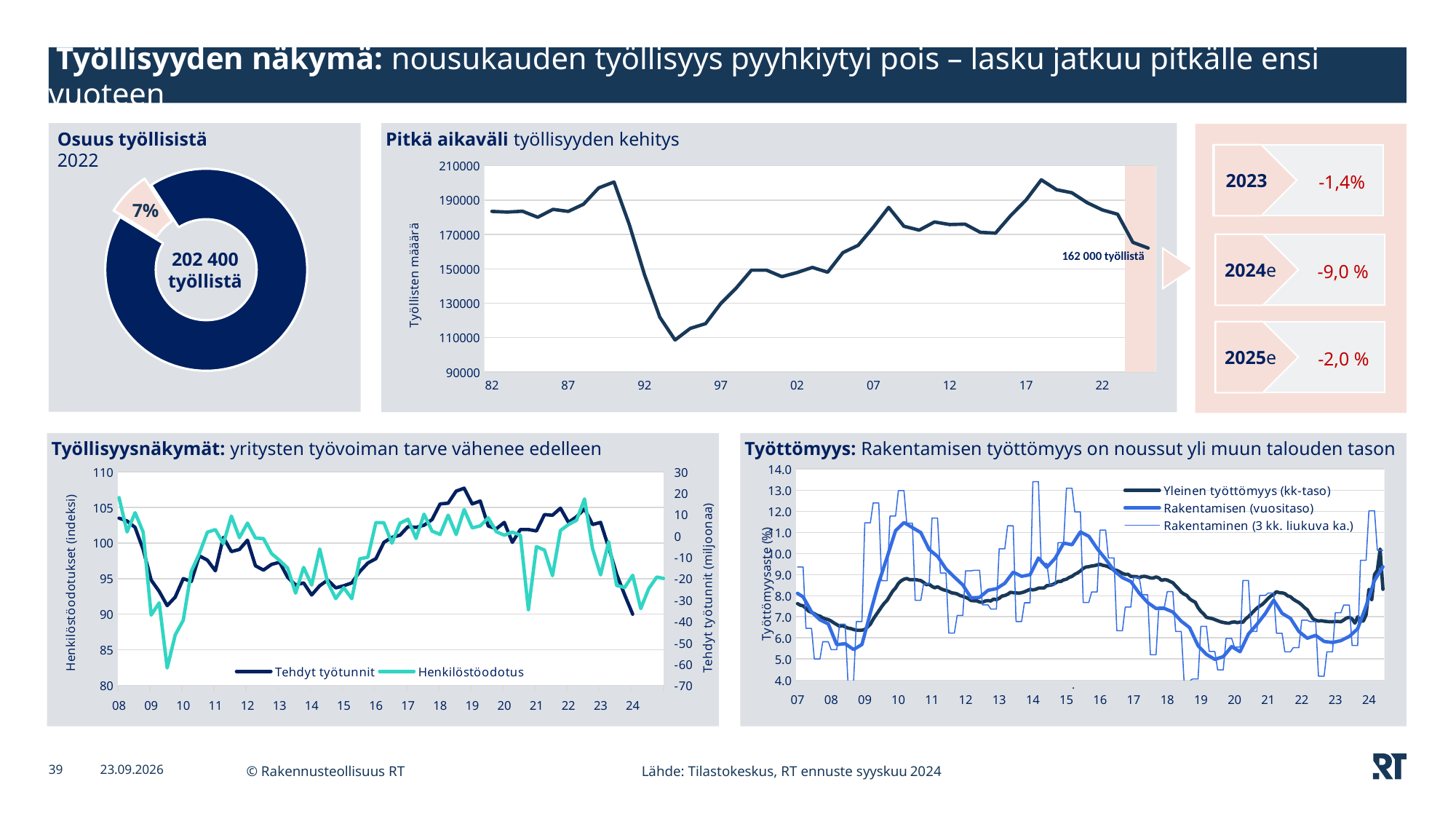
In the 'Osuus työllisistä 2022' chart, what share does the highlighted slice show? 7% In the 'Pitkä aikaväli työllisyyden kehitys' chart, is the value at 82 greater or less than 170000? greater What kind of chart is the 'Osuus työllisistä 2022' chart? pie (donut) chart In the 'Työllisyysnäkymät' chart, is the lowest value of Henkilöstöodotus (around 2009) greater or less than 85 on the left axis? less In the 'Pitkä aikaväli työllisyyden kehitys' chart, is the peak value around 2018 greater or less than 190000? greater How many series does the legend of the 'Työttömyys' chart list? 3 In the 'Pitkä aikaväli työllisyyden kehitys' chart, do the values rise or fall from the 2018 peak to the end of the series? fall In the 'Pitkä aikaväli työllisyyden kehitys' chart, what value is printed as the data label at the end of the line? 162 000 työllistä What are the two legend entries in the 'Työllisyysnäkymät' chart? Tehdyt työtunnit and Henkilöstöodotus What label is printed in the centre of the 'Osuus työllisistä 2022' chart? 202 400 työllistä How many series does the legend of the 'Työllisyysnäkymät' chart list? 2 What kind of chart is the 'Pitkä aikaväli työllisyyden kehitys' chart? line chart